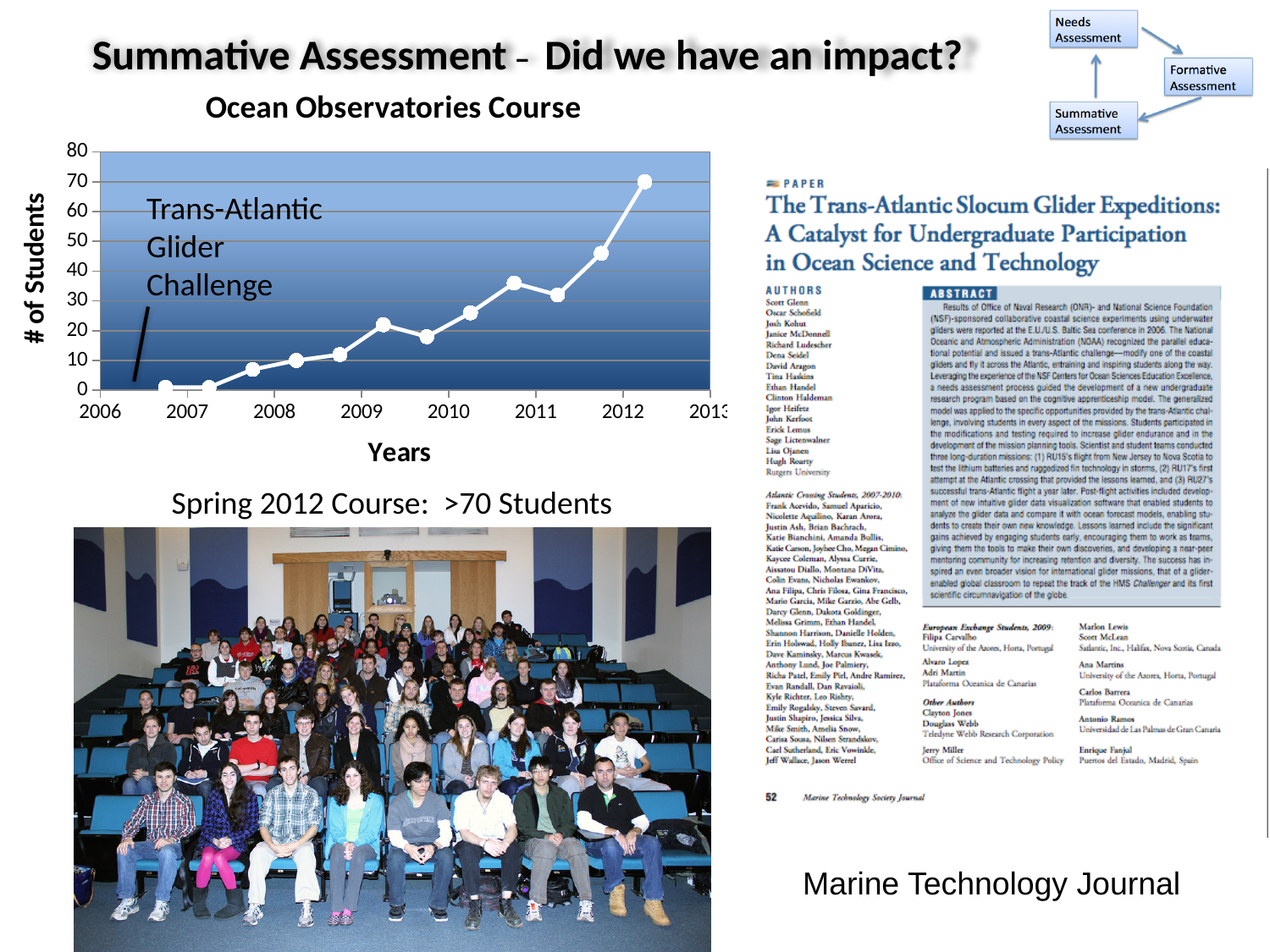
On the Ocean Observatories Course chart, is the value of the last (2012) point greater or less than 60? greater What is the label of the y-axis on the Ocean Observatories Course chart? # of Students What is the highest value shown on the y-axis of the Ocean Observatories Course chart? 80 What is the title of the chart on the left of the slide? Ocean Observatories Course On the Ocean Observatories Course chart, in which year does the line reach its highest point? 2012 On the Ocean Observatories Course chart, which is larger: the value of the last point in 2012 or the value of the point in 2011? 2012 On the Ocean Observatories Course chart, is the value of the highest point in 2010 greater or less than 30? greater On the Ocean Observatories Course chart, is the value of the first plotted point (near 2006-2007) greater or less than 10? less What kind of chart is shown under the heading 'Ocean Observatories Course'? line chart How many data points are plotted on the Ocean Observatories Course chart? 12 On the Ocean Observatories Course chart, do the values generally rise or fall from 2006 to 2012? rise